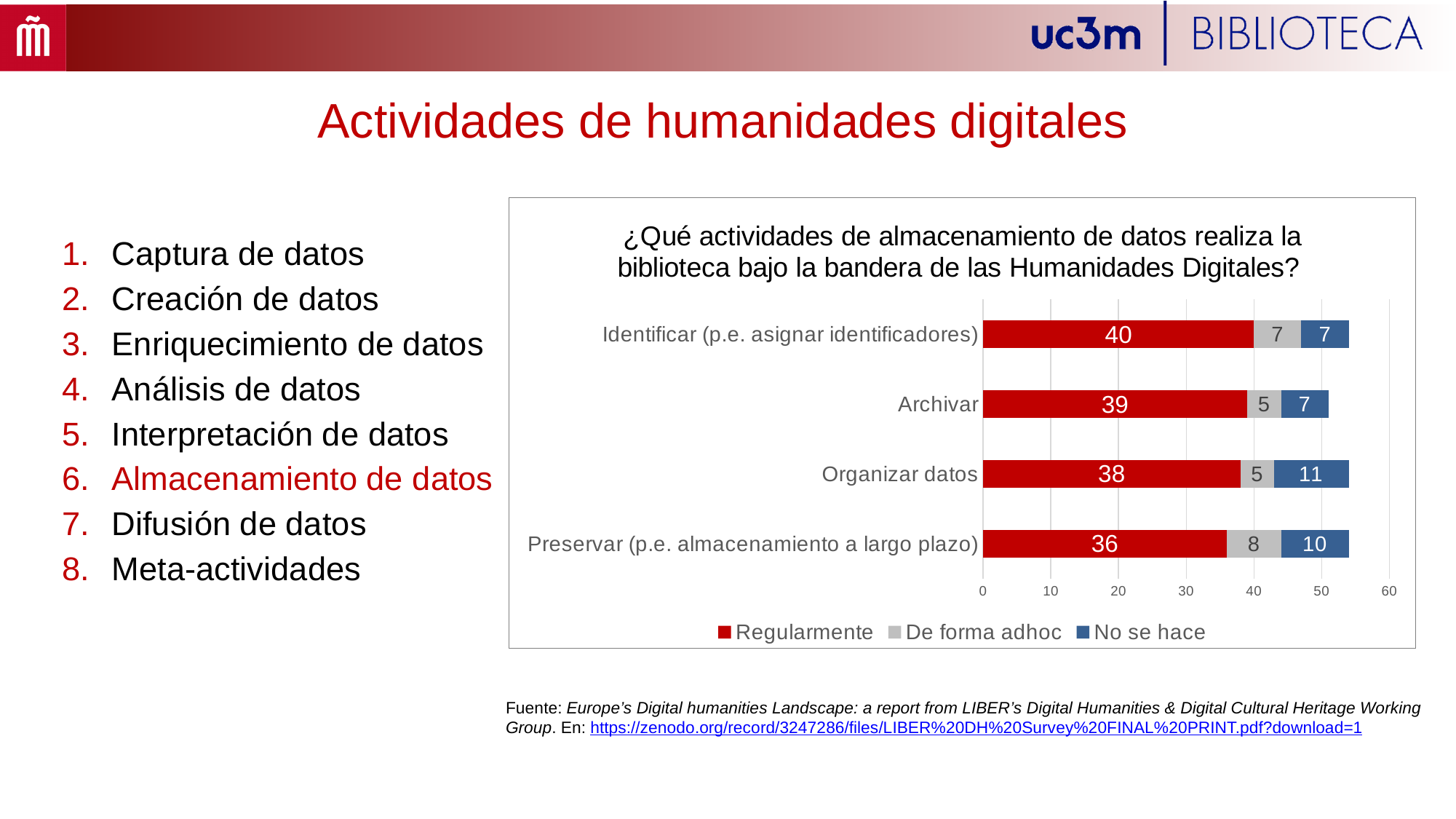
Which category has the lowest 'Regularmente' value? Preservar (p.e. almacenamiento a largo plazo) Which is larger: the 'No se hace' value for Organizar datos or for Archivar? Organizar datos What is the 'De forma adhoc' value for Preservar (p.e. almacenamiento a largo plazo)? 8 What is the 'Regularmente' value for Identificar (p.e. asignar identificadores)? 40 What is the total of the stacked bar for Identificar (p.e. asignar identificadores)? 54 What is the total of the stacked bar for Archivar? 51 How many categories are shown in the chart? 4 Which category has the highest 'Regularmente' value? Identificar (p.e. asignar identificadores) What is the difference between the 'Regularmente' values for Archivar and Preservar (p.e. almacenamiento a largo plazo)? 3 What is the 'No se hace' value for Organizar datos? 11 How many series does the legend list? 3 What kind of chart is shown on the slide? Stacked bar chart